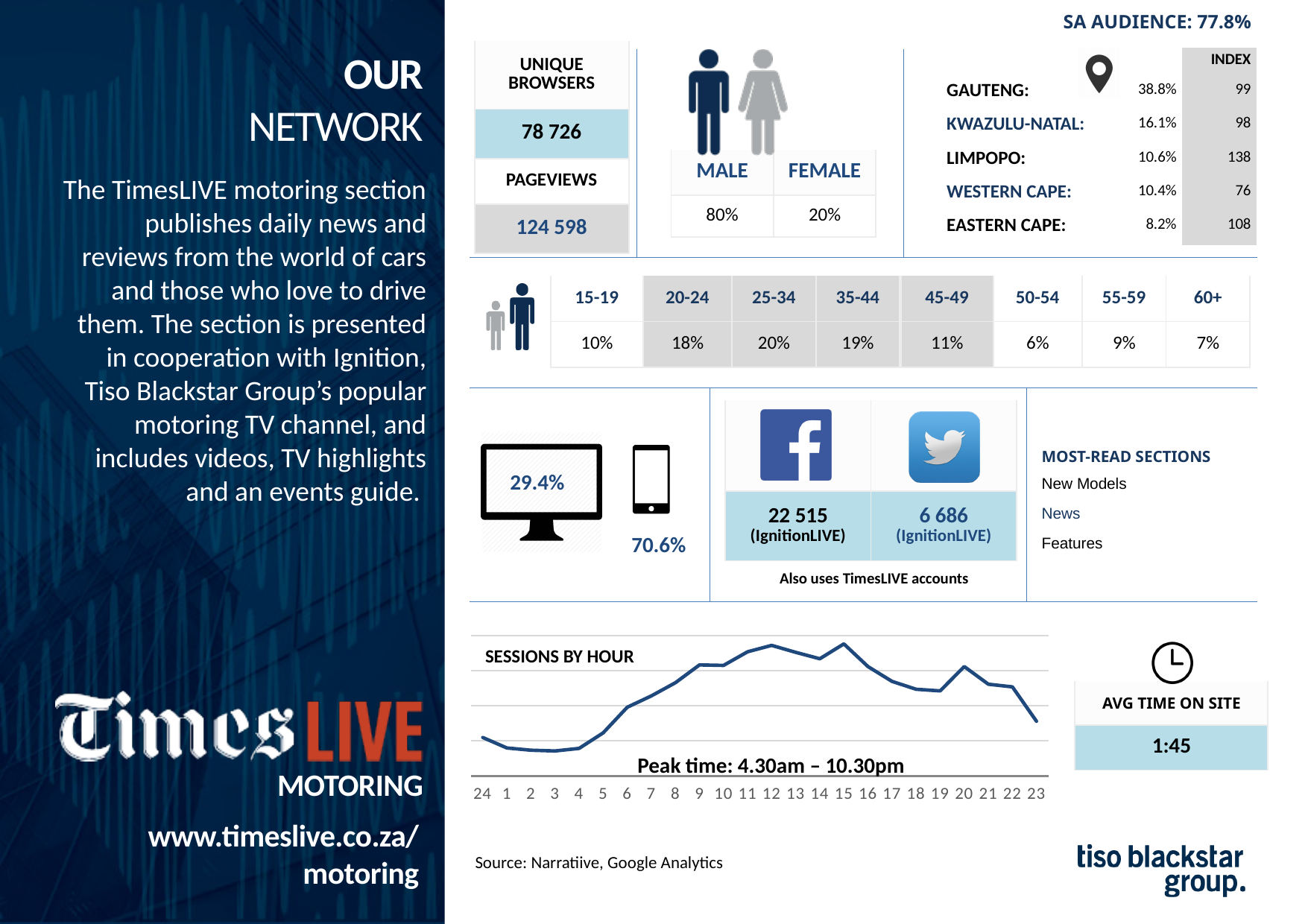
In the 'Sessions by Hour' chart, do sessions rise or fall between hour 20 and hour 23? fall What is the title of the chart at the bottom of the slide? SESSIONS BY HOUR What kind of chart is the 'Sessions by Hour' chart? line chart How many hour labels are shown along the x axis of the 'Sessions by Hour' chart? 24 In the 'Sessions by Hour' chart, which hour has more sessions, 9 or 1? 9 In the 'Sessions by Hour' chart, which hour has more sessions, 15 or 23? 15 What peak time is annotated on the 'Sessions by Hour' chart? 4.30am – 10.30pm In the 'Sessions by Hour' chart, do sessions rise or fall between hour 4 and hour 9? rise What is the first hour label on the x axis of the 'Sessions by Hour' chart? 24 In the 'Sessions by Hour' chart, which hour has more sessions, 12 or 3? 12 How many lines are plotted in the 'Sessions by Hour' chart? 1 In the 'Sessions by Hour' chart, do sessions rise or fall between hour 15 and hour 19? fall